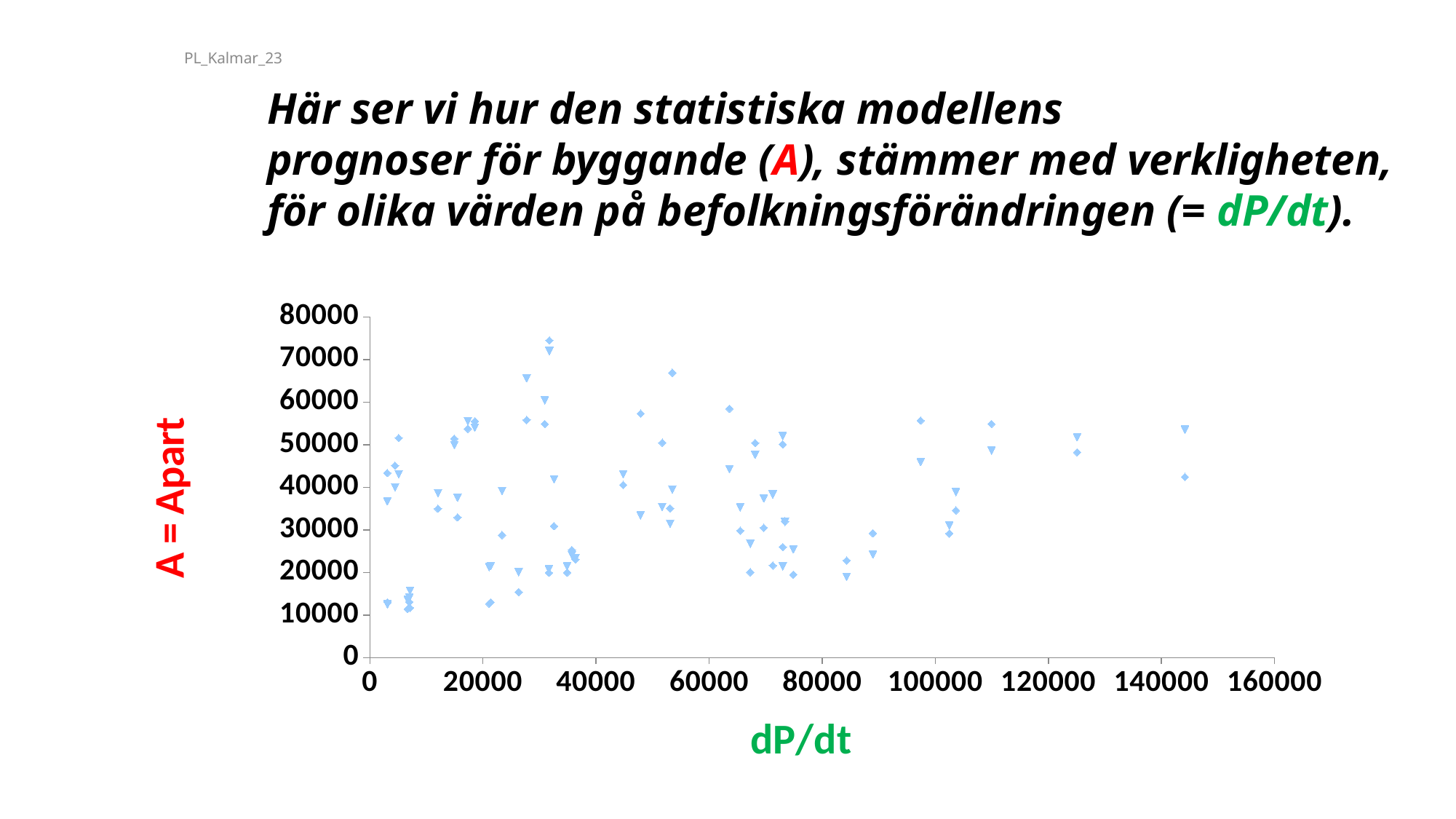
What kind of chart is shown on the slide? scatter chart Is the highest A value plotted on the chart greater or less than 70000? greater What is the label of the horizontal axis of the chart? dP/dt Is the highest A value plotted on the chart greater or less than 80000? less Is the largest dP/dt value plotted on the chart greater or less than 140000? greater What is the label of the vertical axis of the chart? A = Apart